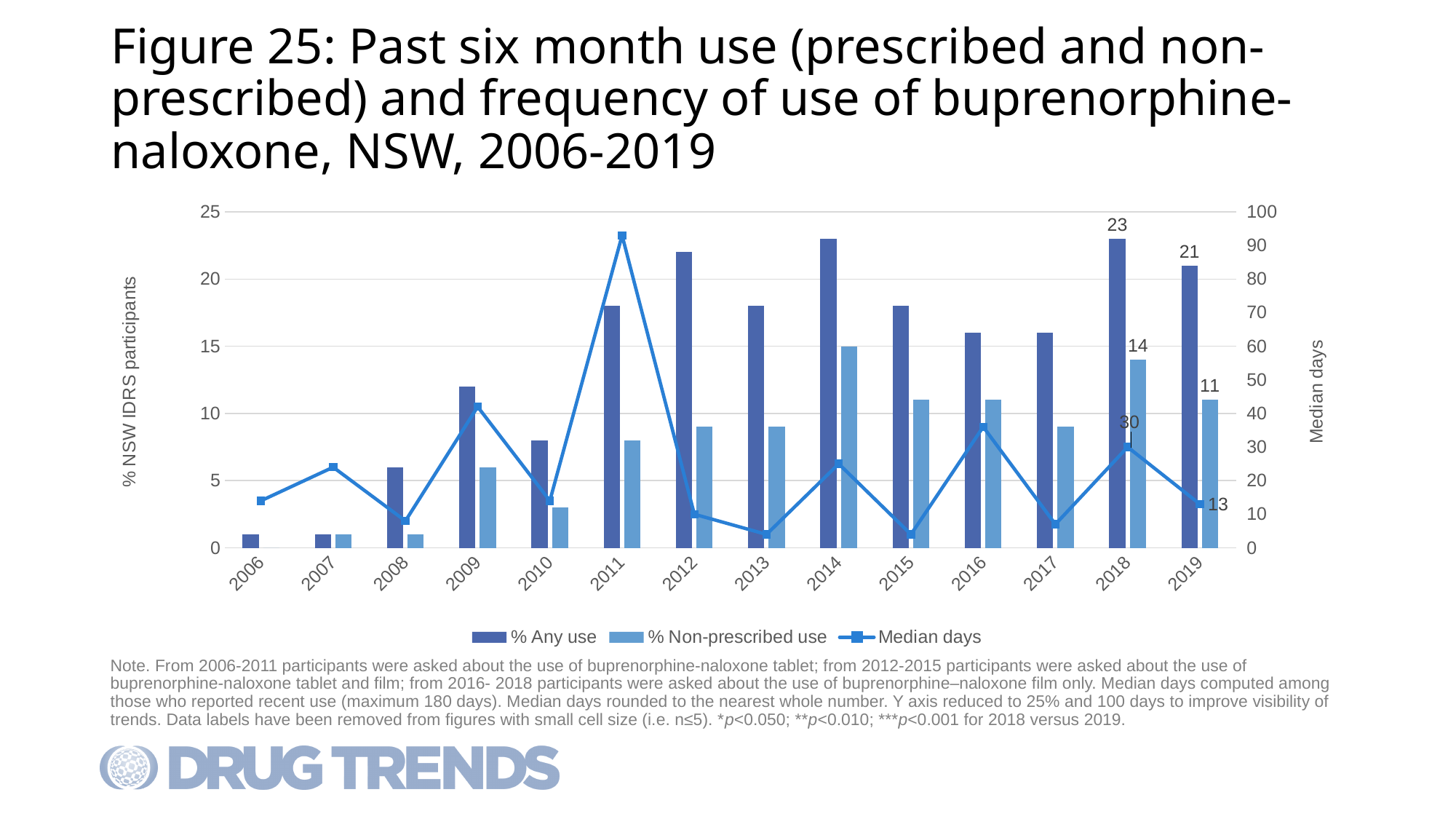
How many years are shown on the x axis? 14 Which year has the higher % Any use, 2010 or 2012? 2012 What is the value of % Non-prescribed use in 2019? 11 How many series does the legend list? 3 By how much did Median days fall from 2018 to 2019? 17 What is the Median days value in 2018? 30 Does Median days rise or fall from 2018 to 2019? fall Is the Median days value for 2011 greater or less than 80? greater Is the % Any use value for 2012 greater or less than 20? greater What is the value of % Any use in 2018? 23 In which year is Median days highest? 2011 What is the difference between % Any use in 2018 and 2019? 2